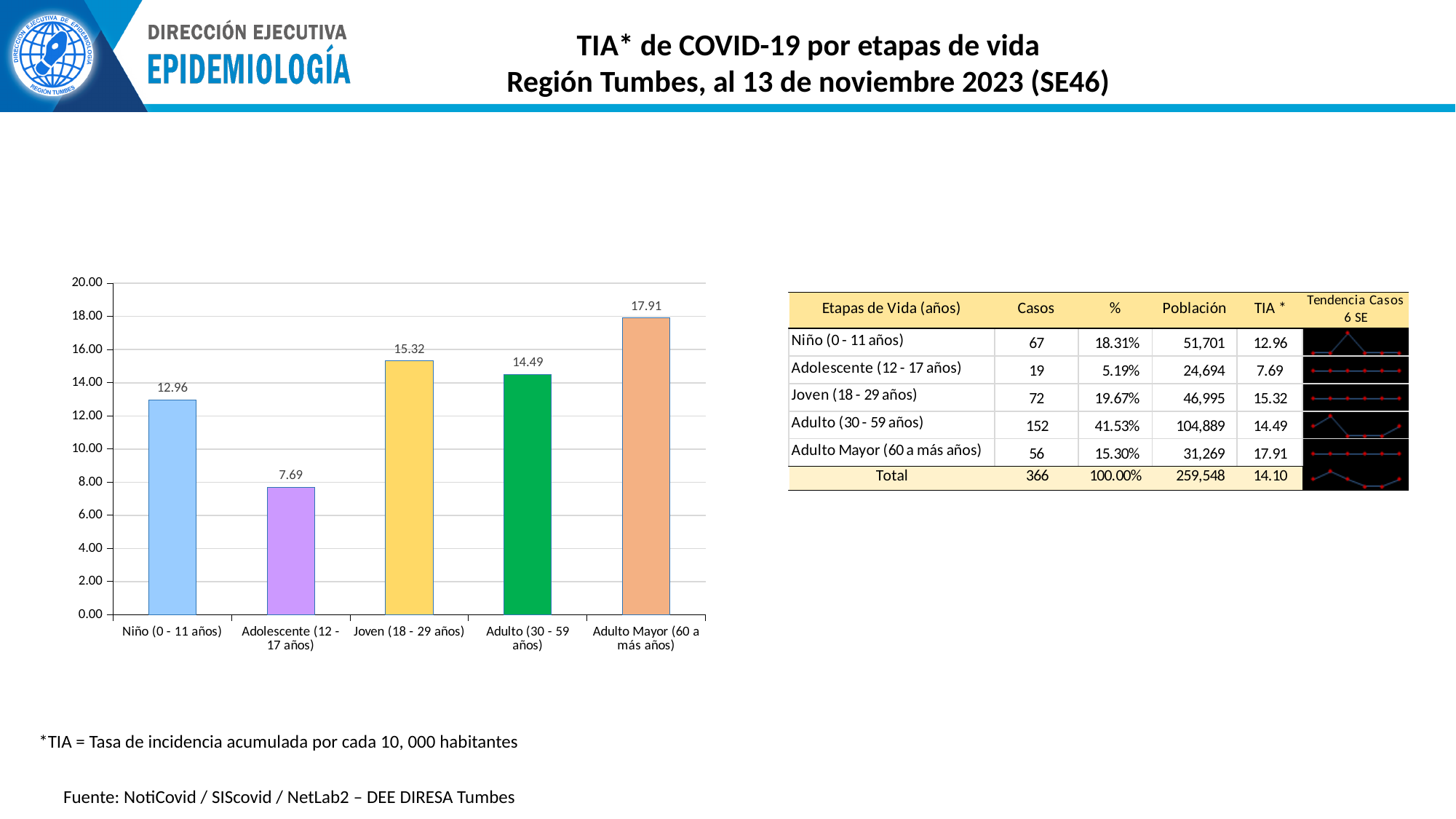
Which life stage has the highest TIA in the bar chart? Adulto Mayor (60 a más años) Which life stage has the lowest TIA in the bar chart? Adolescente (12 - 17 años) Is the TIA value for Adulto (30 - 59 años) greater or less than 14.00? greater What is the difference between the TIA for Adulto Mayor (60 a más años) and Niño (0 - 11 años)? 4.95 What is the TIA value shown for Adolescente (12 - 17 años) in the bar chart? 7.69 What is the TIA value shown for Adulto Mayor (60 a más años) in the bar chart? 17.91 How many life-stage categories are plotted in the bar chart? 5 What is the TIA value shown for Niño (0 - 11 años) in the bar chart? 12.96 Which has a higher TIA in the bar chart, Joven (18 - 29 años) or Adulto (30 - 59 años)? Joven (18 - 29 años) What type of chart is used to show TIA by life stage? Bar chart What is the maximum value shown on the vertical axis of the bar chart? 20.00 What is the TIA value shown for Joven (18 - 29 años) in the bar chart? 15.32